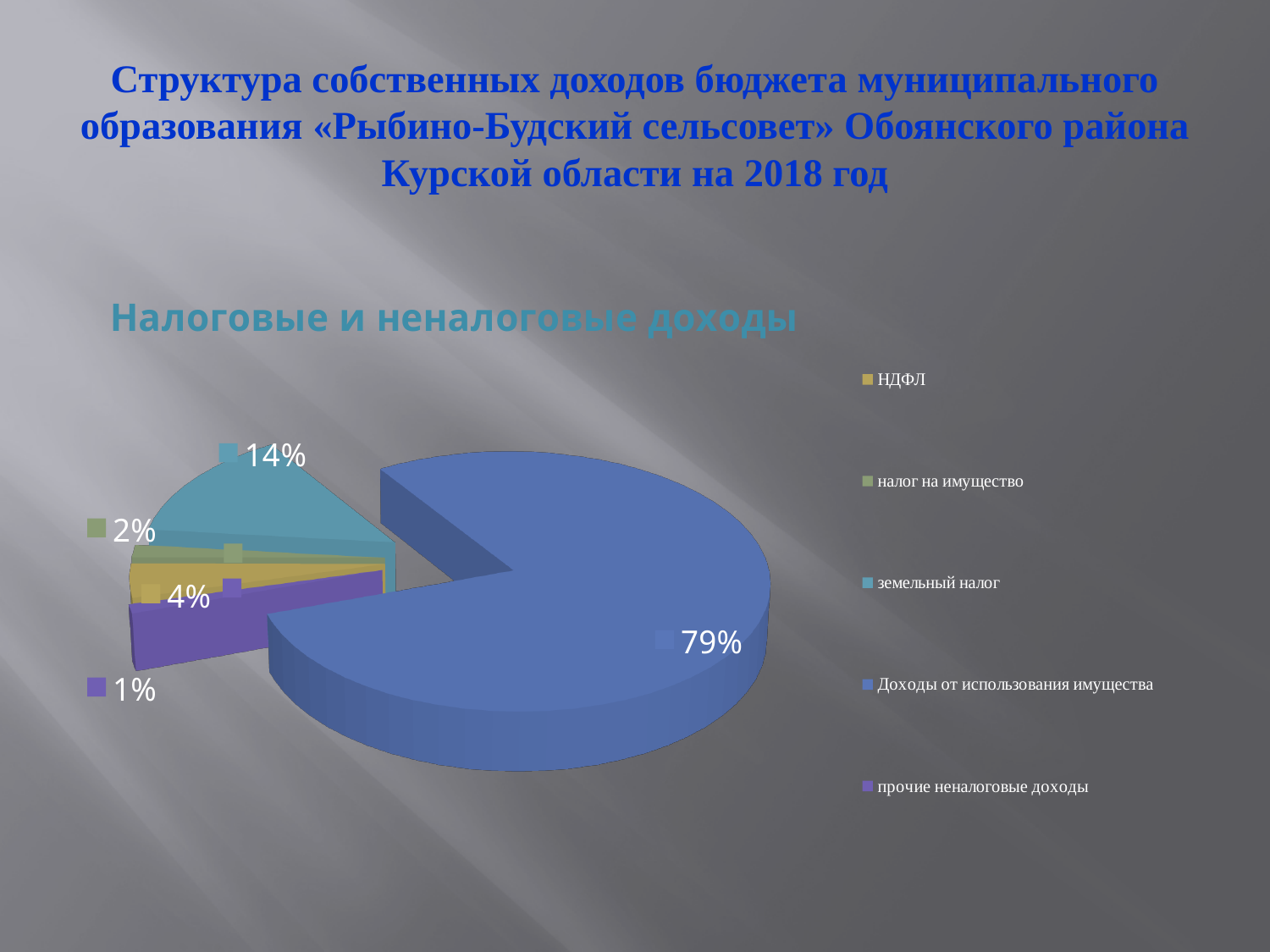
What kind of chart is shown on the slide? Pie chart What share of the pie is labelled for Доходы от использования имущества? 79% What share of the pie is labelled for прочие неналоговые доходы? 1% What share of the pie is labelled for земельный налог? 14% Which slice is larger, НДФЛ or налог на имущество? НДФЛ Which category has the largest slice of the pie? Доходы от использования имущества Which category has the smallest slice of the pie? прочие неналоговые доходы How many categories does the legend of the pie chart list? 5 What is the difference in percentage points between the земельный налог slice and the НДФЛ slice? 10 What is the title of the chart? Налоговые и неналоговые доходы